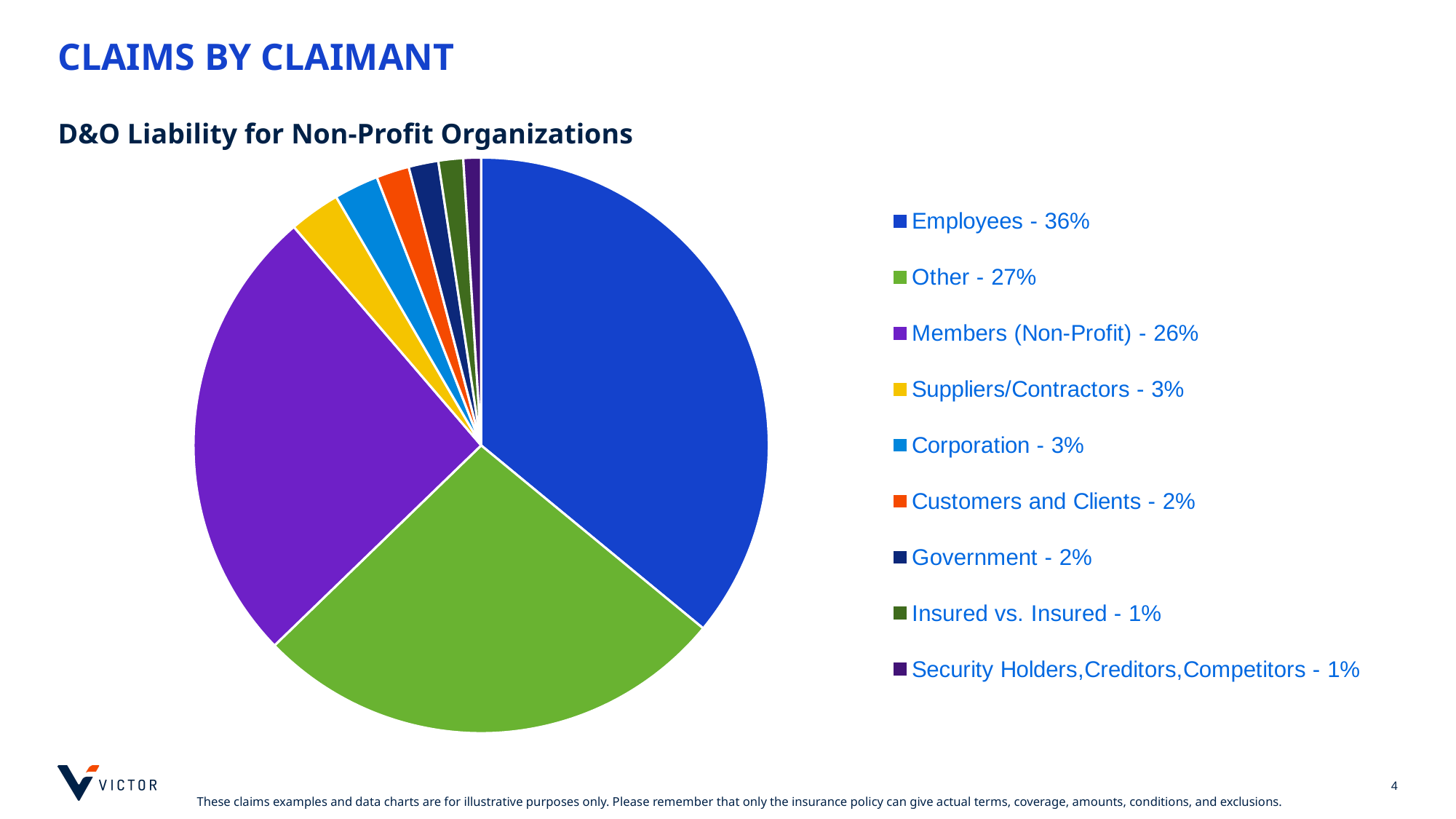
What colour is the slice for Suppliers/Contractors? Yellow What is the combined share of Employees, Other and Members (Non-Profit)? 89% What is the difference in share between Employees and Other? 9% What type of chart is shown on the slide? Pie chart Which claimant category has the largest share of claims? Employees Which has a larger share of claims, Suppliers/Contractors or Government? Suppliers/Contractors What share of claims is attributed to Customers and Clients? 2% What is the difference in share between Other and Members (Non-Profit)? 1% What share of claims is attributed to Employees? 36% What is the subtitle shown above the pie chart? D&O Liability for Non-Profit Organizations How many claimant categories does the legend list? 9 What share of claims is attributed to Members (Non-Profit)? 26%